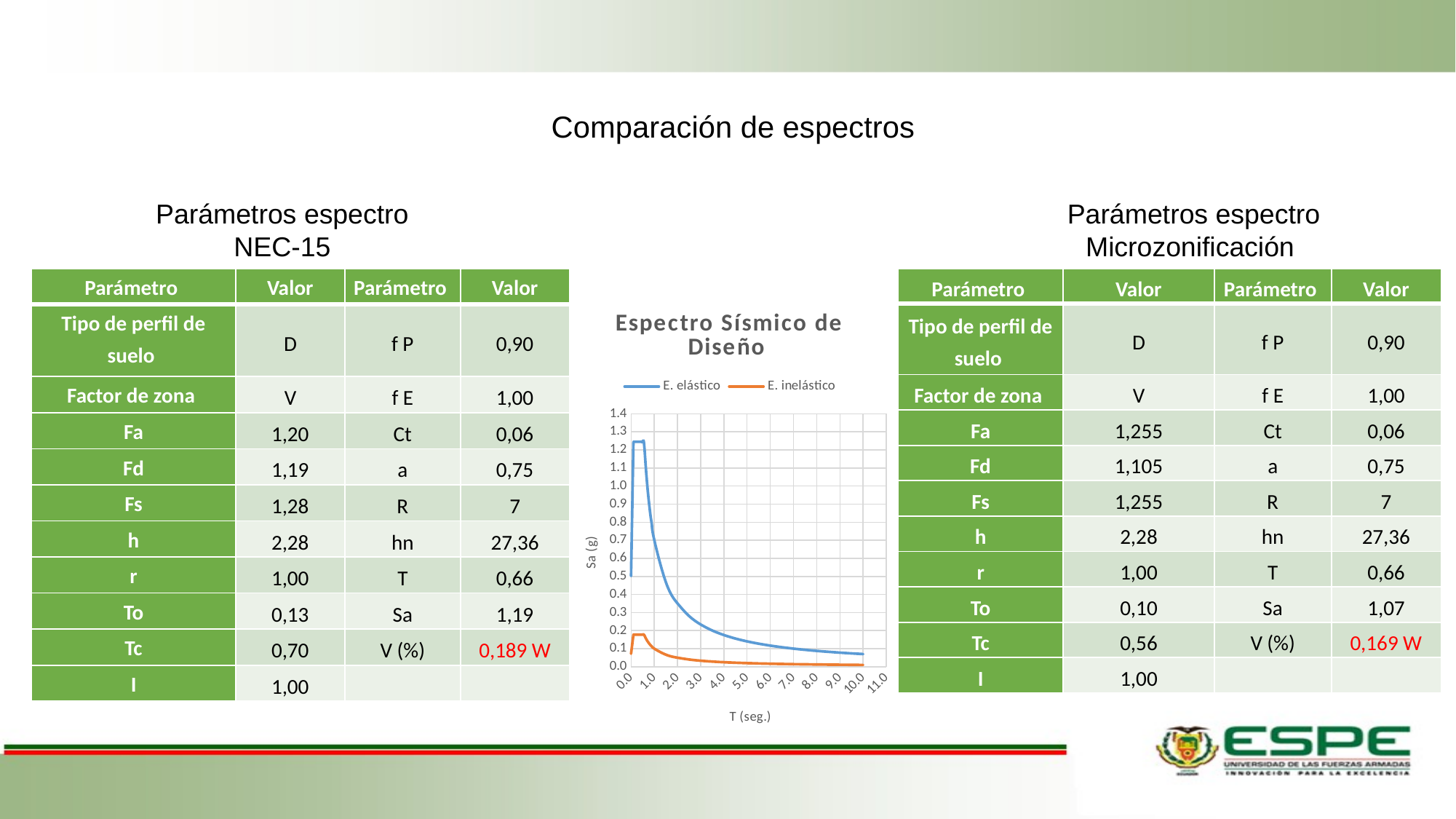
In the "Espectro Sísmico de Diseño" chart, what is the highest tick value shown on the vertical axis? 1.4 In the "Espectro Sísmico de Diseño" chart, which series has the higher value at T = 2.0, E. elástico or E. inelástico? E. elástico What is the label of the horizontal axis of the "Espectro Sísmico de Diseño" chart? T (seg.) In the "Espectro Sísmico de Diseño" chart, is the value of E. elástico at T = 10.0 greater or less than 0.2? less How many series does the legend of the "Espectro Sísmico de Diseño" chart list? 2 In the "Espectro Sísmico de Diseño" chart, is the value of E. elástico at T = 2.0 greater or less than 0.2? greater What are the two series named in the legend of the "Espectro Sísmico de Diseño" chart? E. elástico and E. inelástico What kind of chart is "Espectro Sísmico de Diseño"? line chart In the "Espectro Sísmico de Diseño" chart, after its peak, does the E. elástico series rise or fall as T increases? fall In the "Espectro Sísmico de Diseño" chart, which series reaches the highest value overall? E. elástico In the "Espectro Sísmico de Diseño" chart, is the peak value of E. inelástico greater or less than 0.5? less